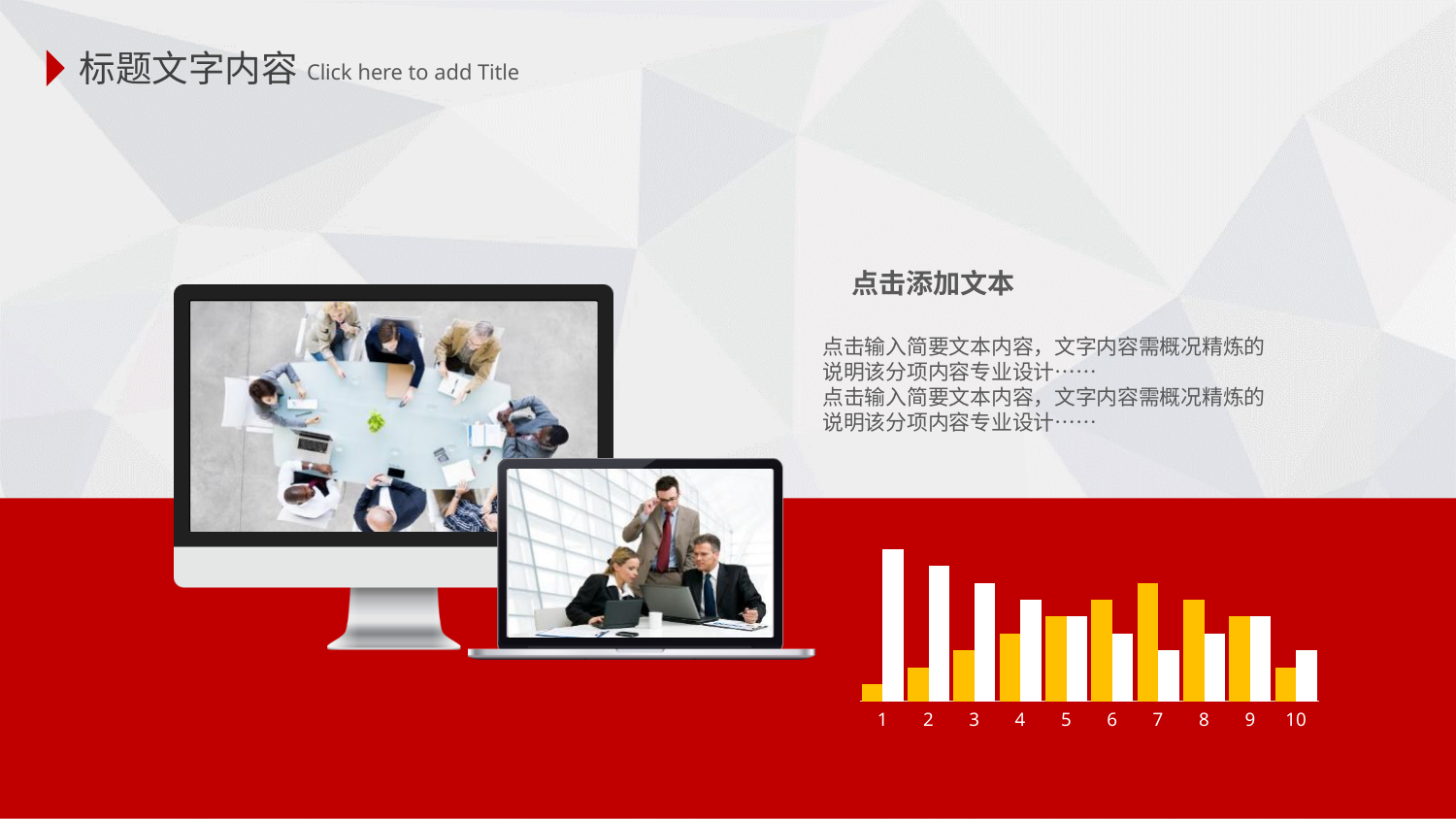
What kind of chart is shown at the bottom right of the slide? bar chart Which category has the tallest white bar in the bar chart? 1 What two colours are used for the bars in the bar chart? yellow and white What is the first category label on the x axis of the bar chart? 1 Do the white bars generally rise or fall from category 1 to category 10? fall How many bar series are plotted in the bar chart? 2 In category 1 of the bar chart, which bar is taller, the yellow one or the white one? white Which category has the shortest yellow bar in the bar chart? 1 Which category has the tallest yellow bar in the bar chart? 7 Which white bar is taller in the bar chart, category 2 or category 3? category 2 In category 7 of the bar chart, which bar is taller, the yellow one or the white one? yellow How many categories are shown on the x axis of the bar chart? 10